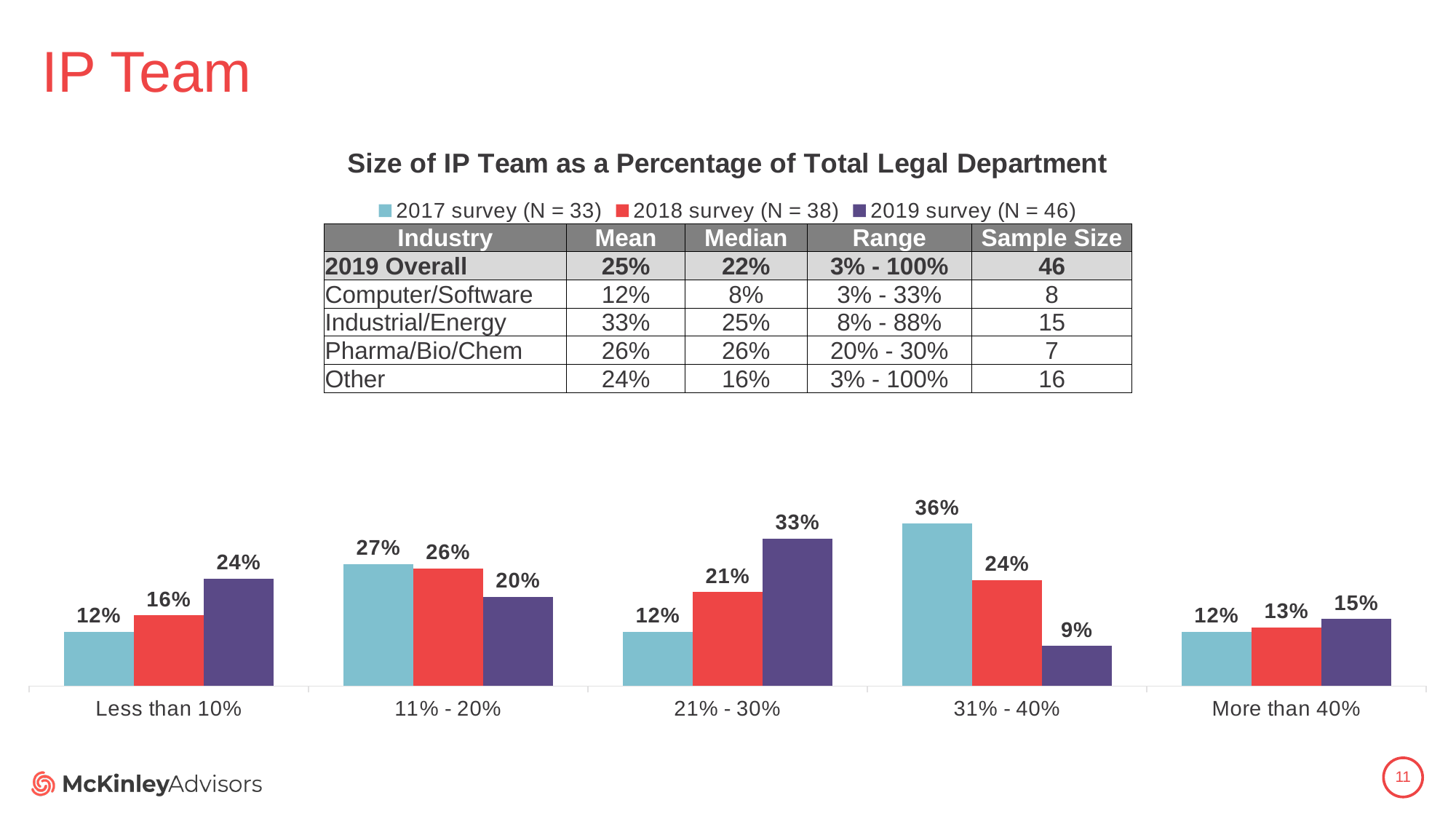
How many series does the chart legend list? 3 Which category has the highest value for the 2019 survey? 21% - 30% How many categories are shown on the x axis of the chart? 5 What is the sample size (N) for the 2018 survey shown in the legend? 38 In the '11% - 20%' category, which is larger: the 2017 survey value or the 2019 survey value? 2017 survey Which category has the lowest value for the 2019 survey? 31% - 40% What is the value for the 2017 survey in the '31% - 40%' category? 36% What kind of chart is shown on the slide? Bar chart What is the value for the 2018 survey in the 'Less than 10%' category? 16% What is the title of the chart? Size of IP Team as a Percentage of Total Legal Department What is the value for the 2019 survey in the '21% - 30%' category? 33% What is the difference between the 2017 survey and 2019 survey values in the '31% - 40%' category? 27%